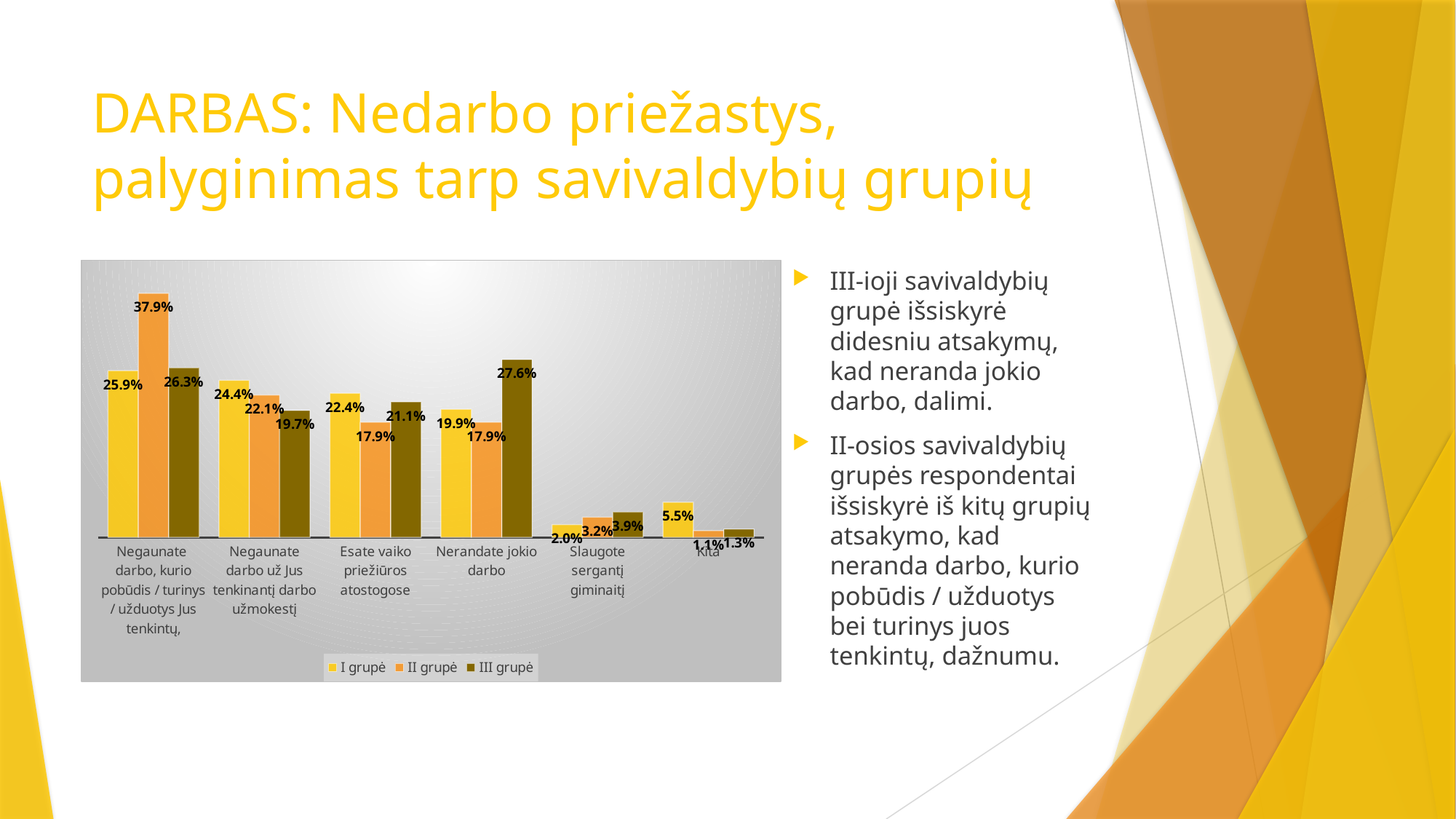
What is the value for II grupė in the category 'Nerandate jokio darbo'? 17.9% How many series does the chart legend list? 3 What is the difference between the II grupė and I grupė values in the category 'Negaunate darbo, kurio pobūdis / turinys / užduotys Jus tenkintų'? 12.0% Which is larger in the category 'Esate vaiko priežiūros atostogose': the value for I grupė or for III grupė? I grupė Which series has the highest value in the category 'Negaunate darbo, kurio pobūdis / turinys / užduotys Jus tenkintų'? II grupė Which category has the lowest value for II grupė? Kita What kind of chart is shown on the slide? bar chart How many categories are shown on the x axis of the chart? 6 What is the value for I grupė in the category 'Kita'? 5.5% What is the value for III grupė in the category 'Nerandate jokio darbo'? 27.6% What colour are the bars for III grupė in the chart? dark brown What is the difference between the III grupė and I grupė values in the category 'Nerandate jokio darbo'? 7.7%